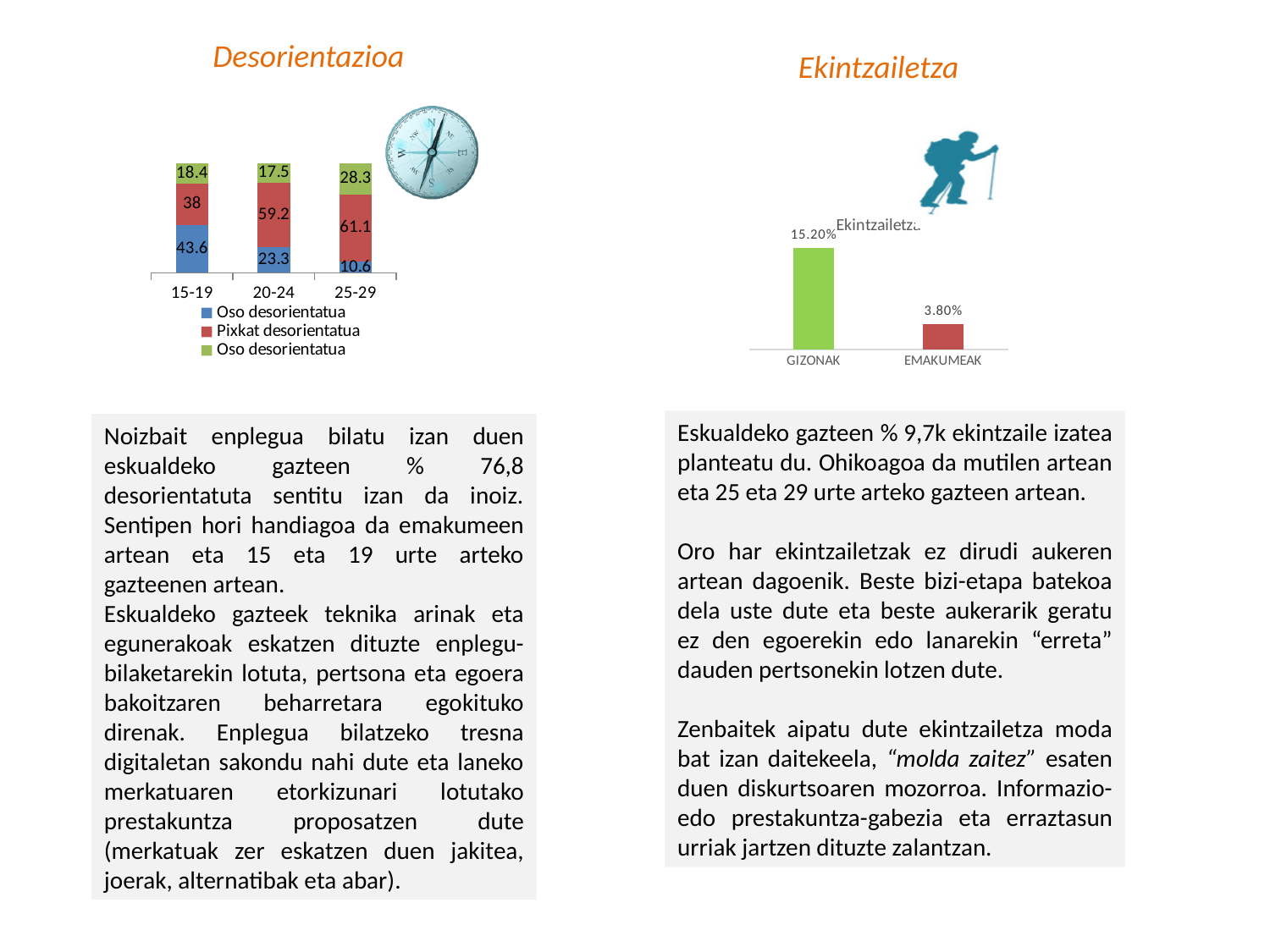
In the Desorientazioa chart, which age group has the highest Pixkat desorientatua value? 25-29 What type of chart is the Ekintzailetza chart? Bar chart In the Desorientazioa chart, what is the value of the blue (bottom) segment for the 20-24 age group? 23.3 In the Desorientazioa chart, what is the total of the stacked bar for the 15-19 age group? 100 In the Desorientazioa chart, what is the value of the Pixkat desorientatua segment for the 15-19 age group? 38 In the Ekintzailetza chart, what is the value for GIZONAK? 15.20% In the Desorientazioa chart, what is the value of the green (top) segment for the 25-29 age group? 28.3 How many age groups are shown on the x axis of the Desorientazioa chart? 3 In the Desorientazioa chart, what is the difference between the Pixkat desorientatua values for 25-29 and 15-19? 23.1 In the Desorientazioa chart, which age group has the lowest value for the blue (bottom) segment? 25-29 In the Ekintzailetza chart, what is the difference between the values for GIZONAK and EMAKUMEAK? 11.40% In the Desorientazioa chart, what is the value of the Pixkat desorientatua segment for the 25-29 age group? 61.1